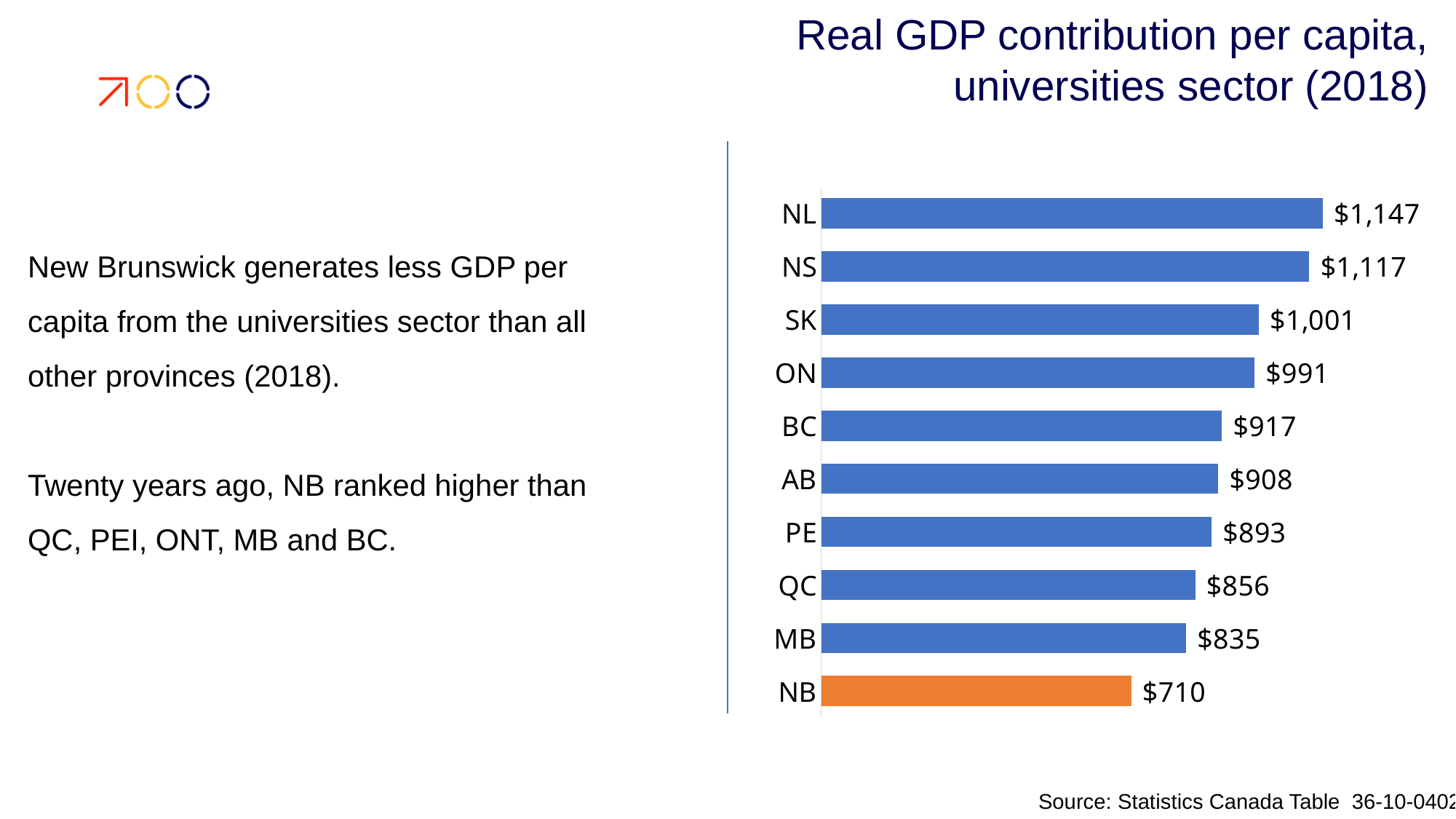
How many provinces are shown in the chart? 10 Which province's bar is coloured orange instead of blue? NB What is the difference between the values for NL and NB? $437 Which province has the highest real GDP contribution per capita from the universities sector? NL What is the real GDP contribution per capita from the universities sector for NL? $1,147 Which has a larger value, PE or NS? NS What kind of chart is shown on the slide? Bar chart What is the value shown for NB? $710 Which province has the lowest real GDP contribution per capita from the universities sector? NB What is the difference between the values for SK and ON? $10 Which has a larger value, QC or MB? QC What is the value shown for ON? $991